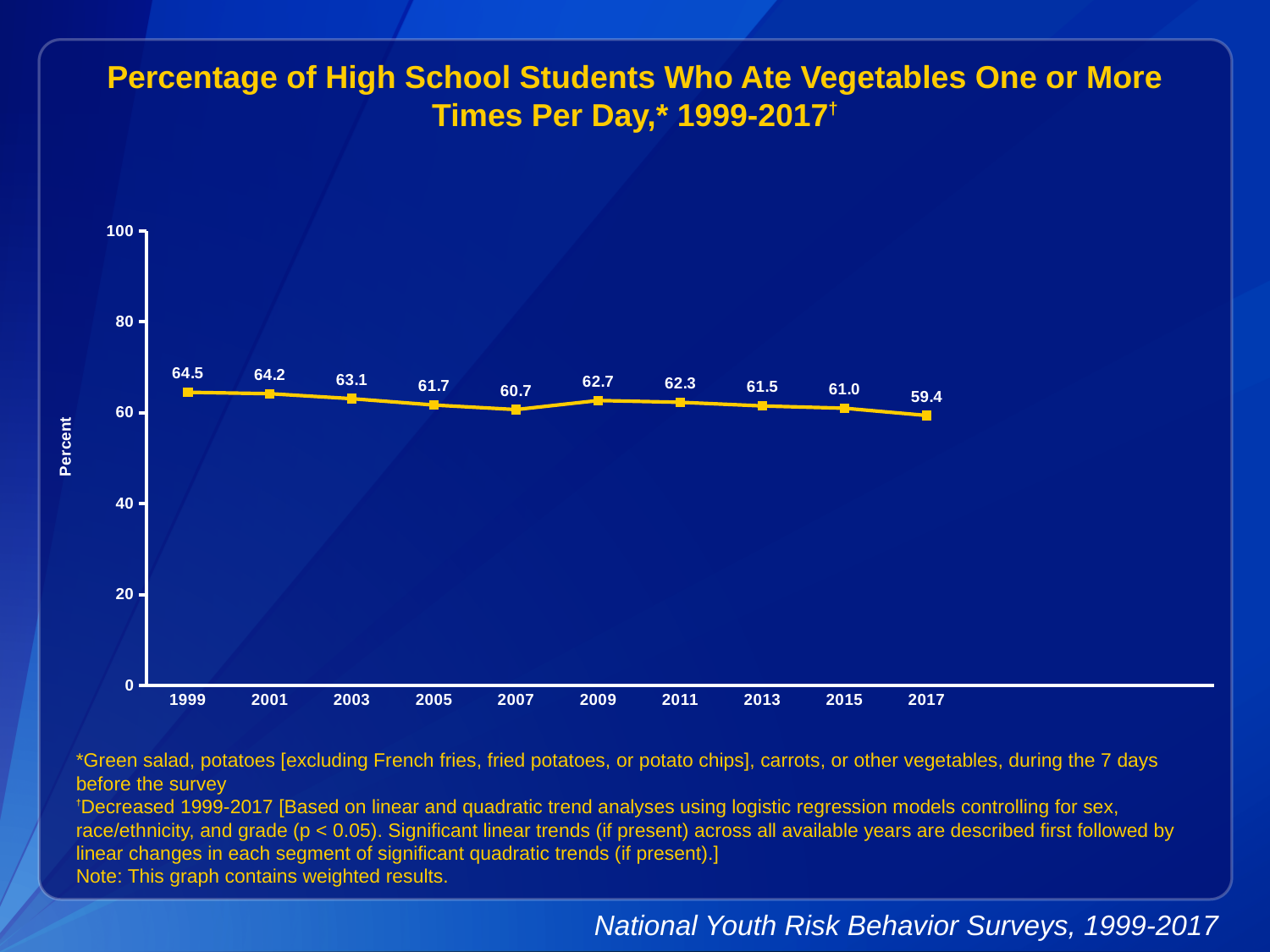
What is the difference between the 1999 value and the 2017 value? 5.1 What value is shown for 2017? 59.4 What is the label on the y axis? Percent Which year has the highest value on the chart? 1999 Overall, do the values rise or fall from 1999 to 2017? fall Which is larger, the value for 2007 or the value for 2009? 2009 What value is shown for 2009? 62.7 What was the percentage of high school students who ate vegetables one or more times per day in 1999? 64.5 How many years are plotted on the chart? 10 Which year has the lowest value on the chart? 2017 Is the value for 2013 greater or less than 80? less What kind of chart is shown on the slide? line chart